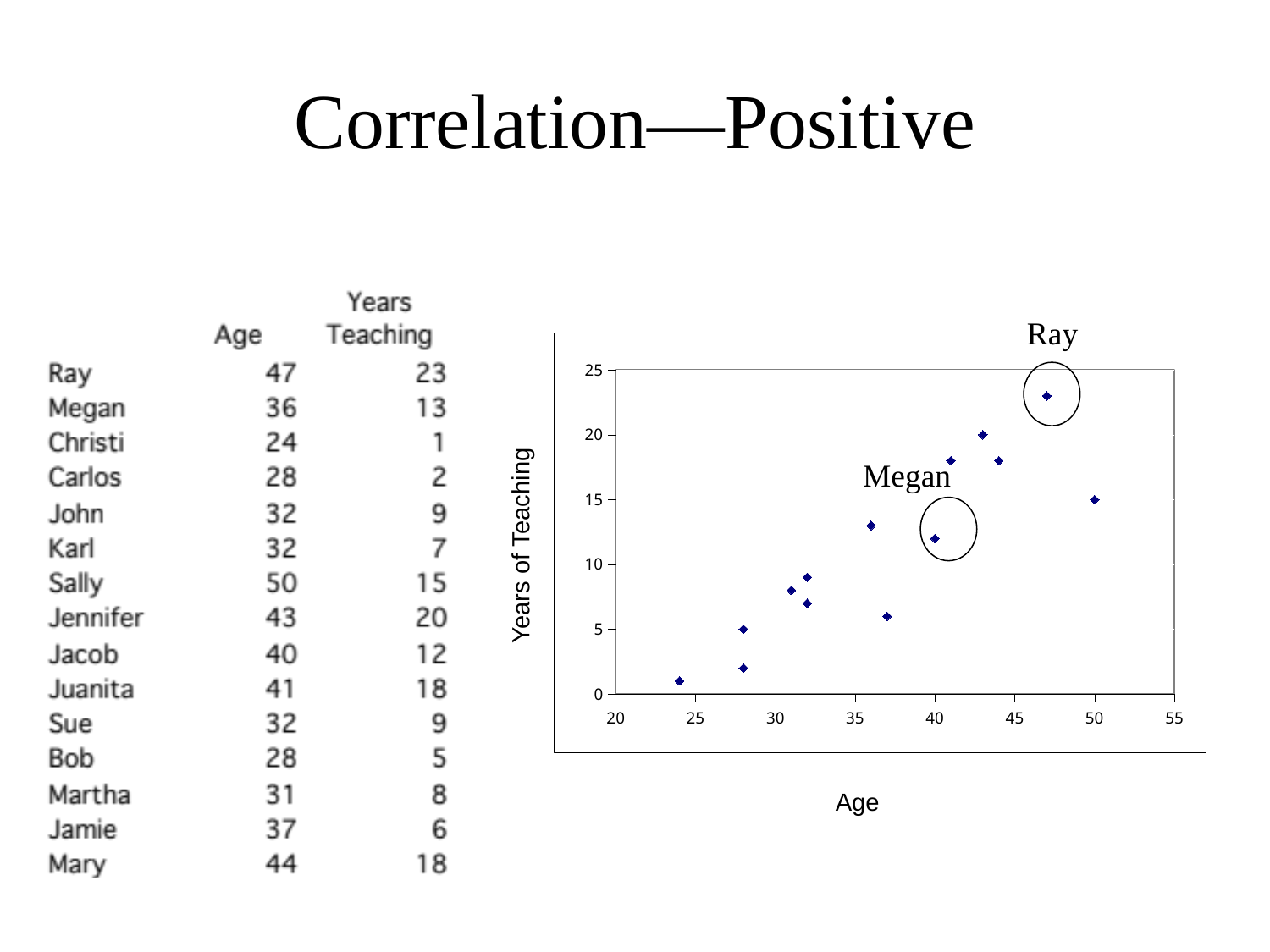
Which person has the lowest number of years teaching? Christi Who has more years teaching, Ray or Sally? Ray What is the label of the y axis of the chart? Years of Teaching What is the difference in years teaching between Ray and Megan? 10 Do the years of teaching generally rise or fall as age increases along the x axis? Rise Is the years of teaching value for the point at age 50 greater or less than 10? greater What is the label of the x axis of the chart? Age Which person has the highest number of years teaching? Ray How many years of teaching does Ray, the circled point at the top right, have? 23 Is the years of teaching value for the point at age 24 greater or less than 5? less What is Ray's age? 47 What kind of chart is shown on the slide? Scatter plot